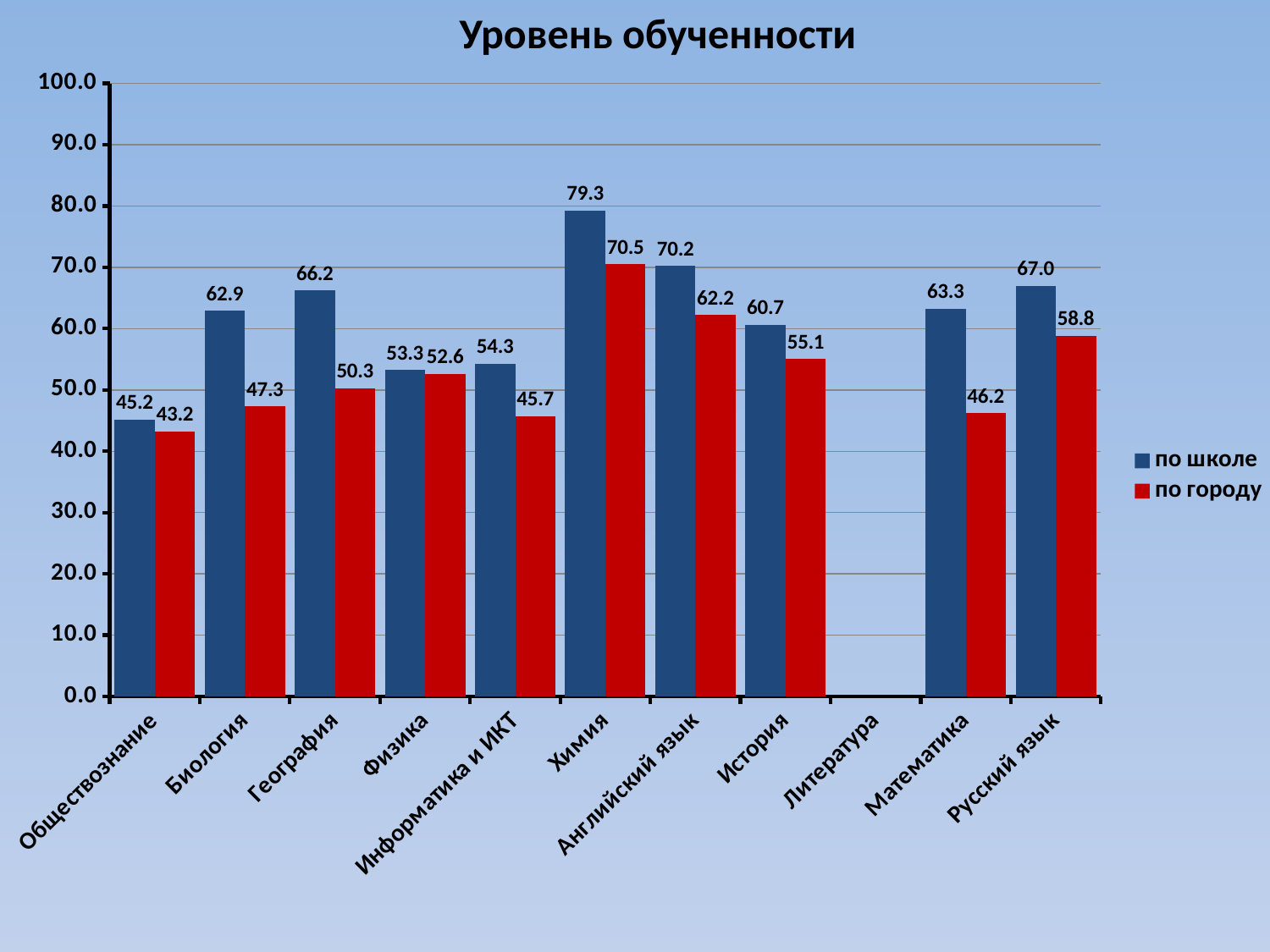
Which category has the highest value in the по городу series? Химия What is the title of the chart? Уровень обученности What is the difference between the по школе values for Химия and Английский язык? 9.1 What is the value for Русский язык in the по школе series? 67.0 What is the value for Математика in the по городу series? 46.2 What is the difference between the по школе and по городу values for Математика? 17.1 Which is larger: the по городу value for Биология or the по городу value for География? География How many series does the legend list? 2 How many categories are listed on the x axis? 11 Which category has the lowest value in the по школе series among those with bars? Обществознание What is the value for Химия in the по школе series? 79.3 What kind of chart is shown on the slide? Bar chart